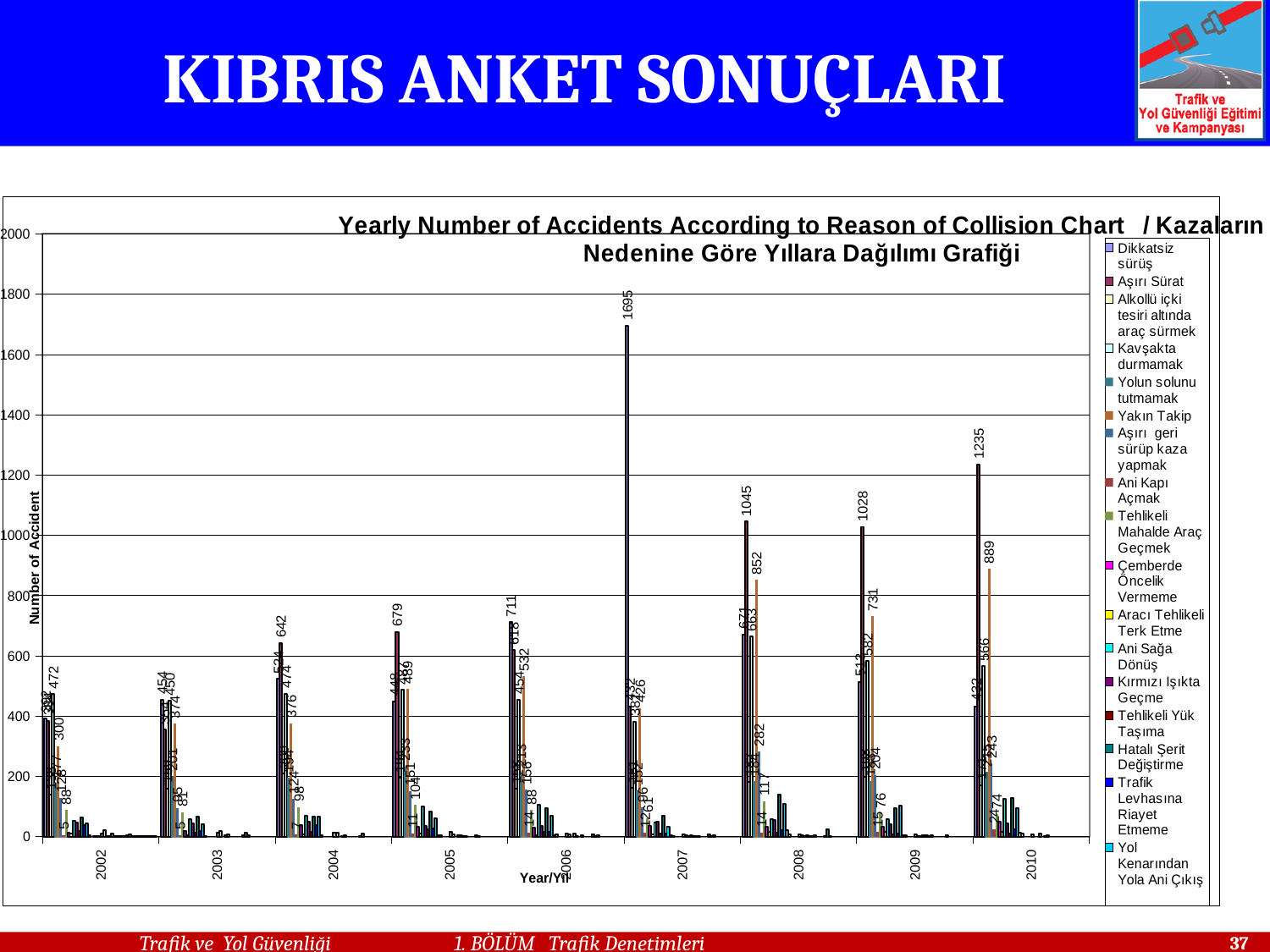
What is the largest value labeled in the 2010 group? 1235 What is the first entry listed in the legend? Dikkatsiz sürüş What is the highest data label shown on the chart? 1695 What is the second-largest value labeled in the 2008 group? 852 Is the value of the tallest bar in 2007 greater or less than 1600? greater In which year does the tallest bar of the chart appear? 2007 What kind of chart is shown on the slide? bar chart How many years are shown along the x axis? 9 How many series does the legend list? 17 What is the difference between the tallest bar in 2007 (1695) and the tallest bar in 2010 (1235)? 460 What is the title of the vertical axis? Number of Accident Which is larger: the tallest bar in 2008 (1045) or the tallest bar in 2009 (1028)? 2008 (1045)